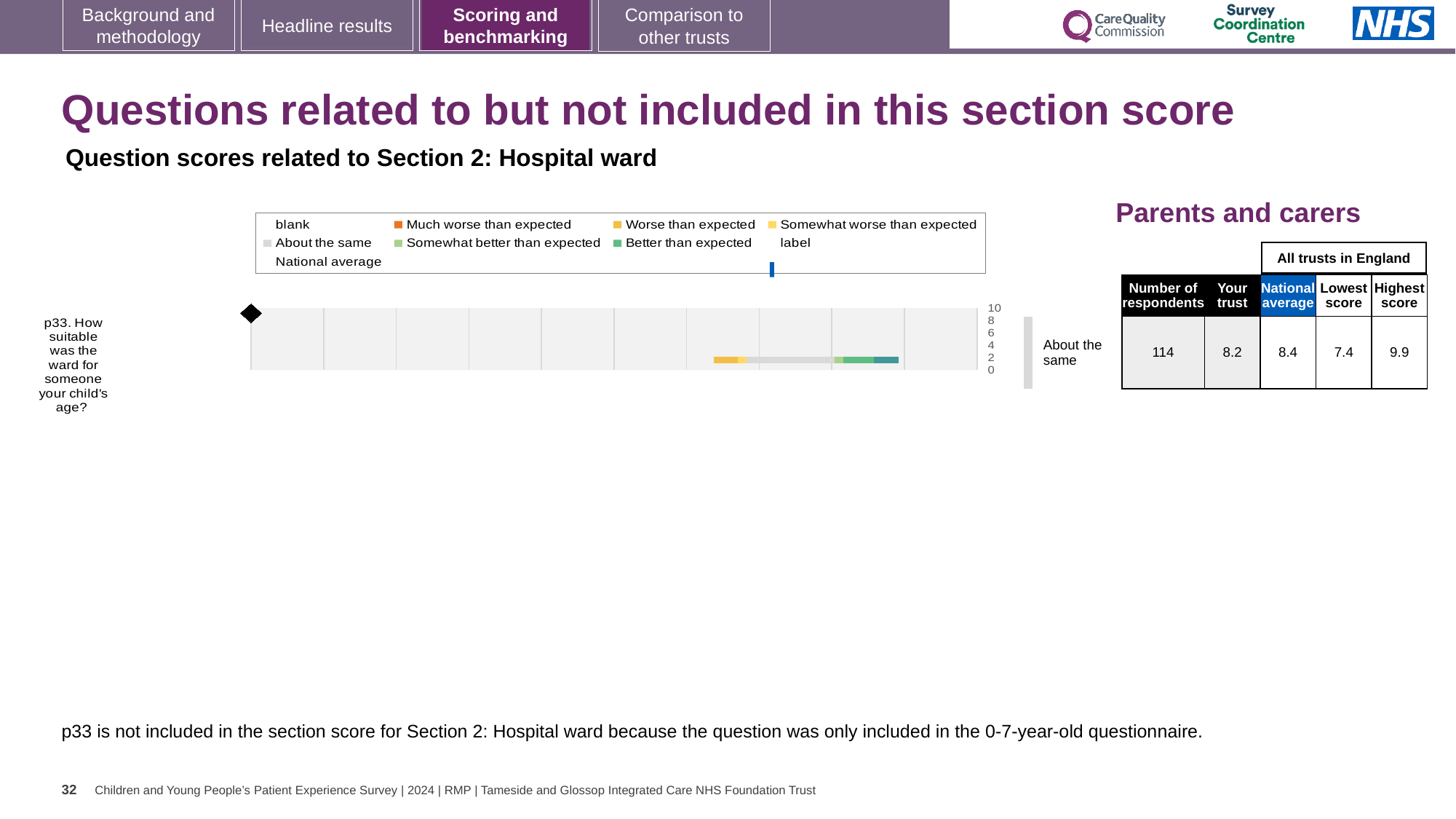
What benchmark category is shown next to the bar for p33? About the same How many survey questions are plotted in the chart? 1 What is the lowest score among all trusts in England for p33? 7.4 What is the highest score among all trusts in England for p33? 9.9 What is the national average score for p33? 8.4 What colour represents 'Much worse than expected' in the legend? Orange What is the difference between the highest score and the lowest score for p33? 2.5 What kind of chart is shown for question p33? bar chart Which question is plotted in the chart? p33. How suitable was the ward for someone your child's age? How many respondents answered p33? 114 Which is larger for p33, the 'Your trust' score or the national average? National average What is the 'Your trust' score for p33? 8.2